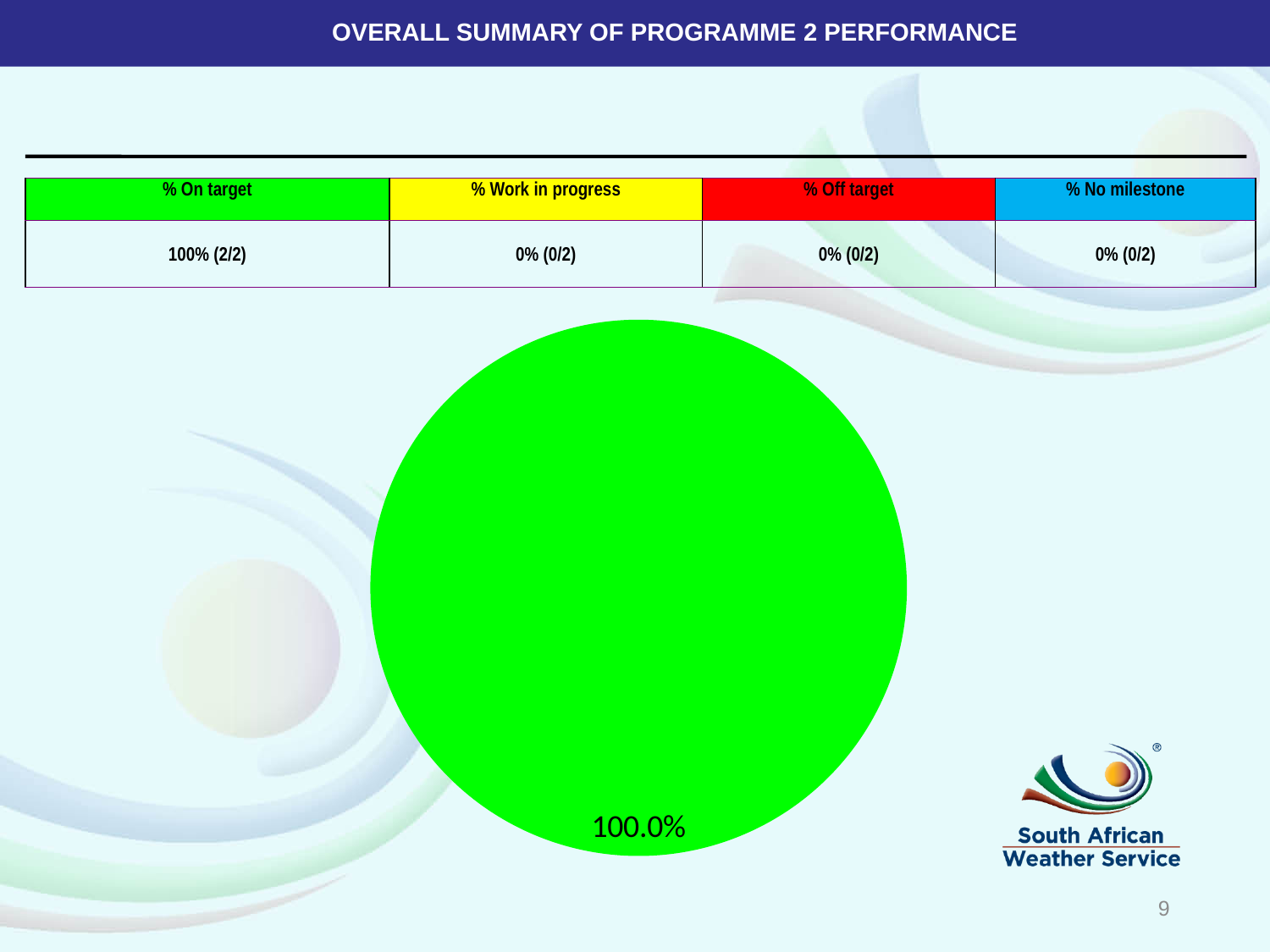
What colour is the single slice of the pie chart? green How many slices are visible in the pie chart? 1 What share of the pie does the green slice represent? 100.0% What percentage is printed as the data label on the pie chart? 100.0% What kind of chart is shown on the slide? pie chart According to the colour key in the table above the chart, which category does the green slice of the pie represent? % On target Does the pie chart show any slice for % Off target? No